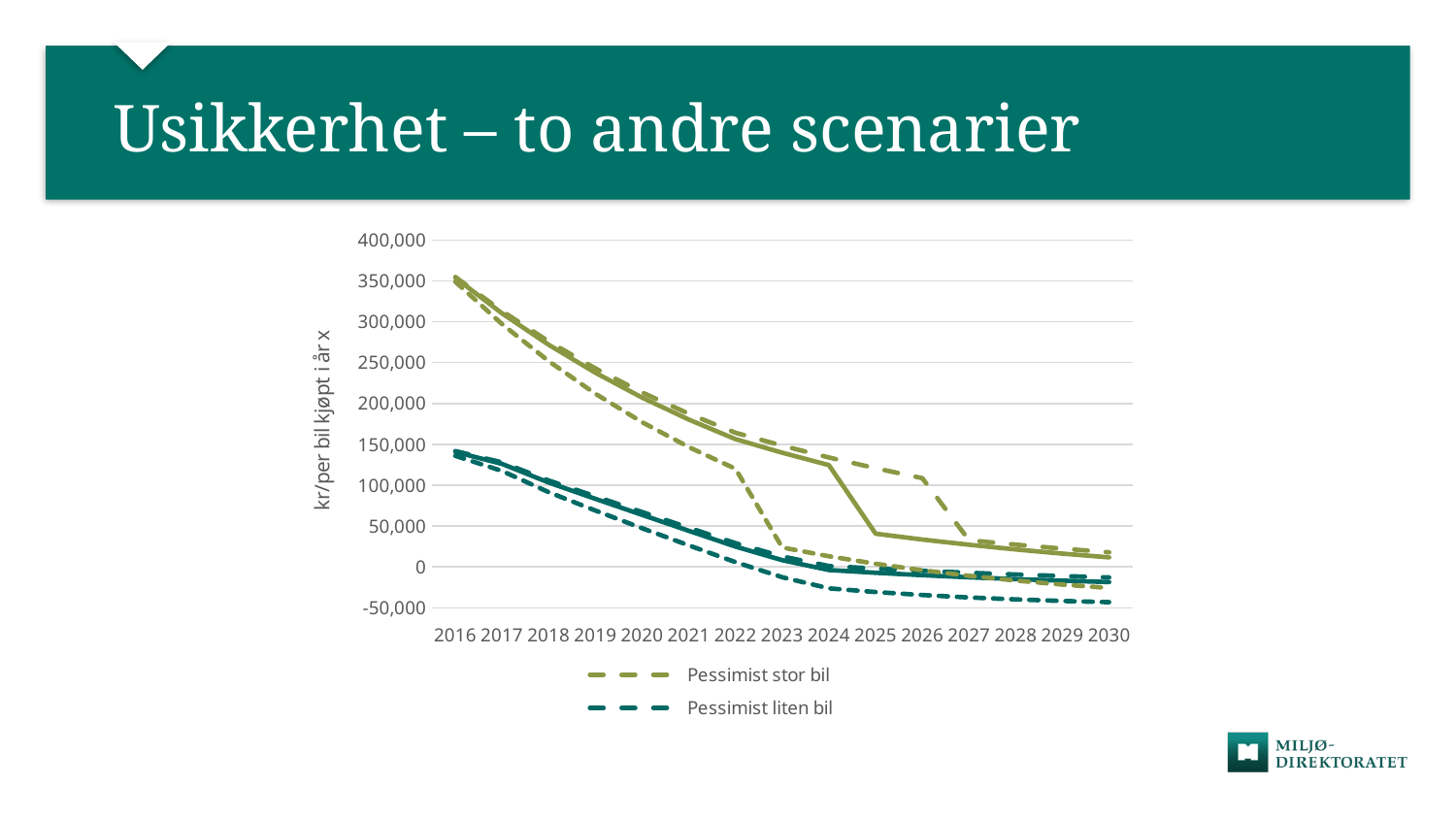
Do the values for Pessimist liten bil rise or fall from 2016 to 2030? fall What kind of chart is shown on the slide? line chart What is the label on the y axis? kr/per bil kjøpt i år x Do the values for Pessimist stor bil rise or fall from 2016 to 2030? fall Which year has the highest value for Pessimist stor bil? 2016 Is the value for Pessimist liten bil in 2016 greater or less than 200,000? less How many years are shown along the x axis? 15 How many series does the legend list? 2 What is the title of the slide? Usikkerhet – to andre scenarier Is the value for Pessimist liten bil in 2030 greater or less than 50,000? less In 2016, which series has the higher value, Pessimist stor bil or Pessimist liten bil? Pessimist stor bil Is the value for Pessimist stor bil in 2016 greater or less than 300,000? greater